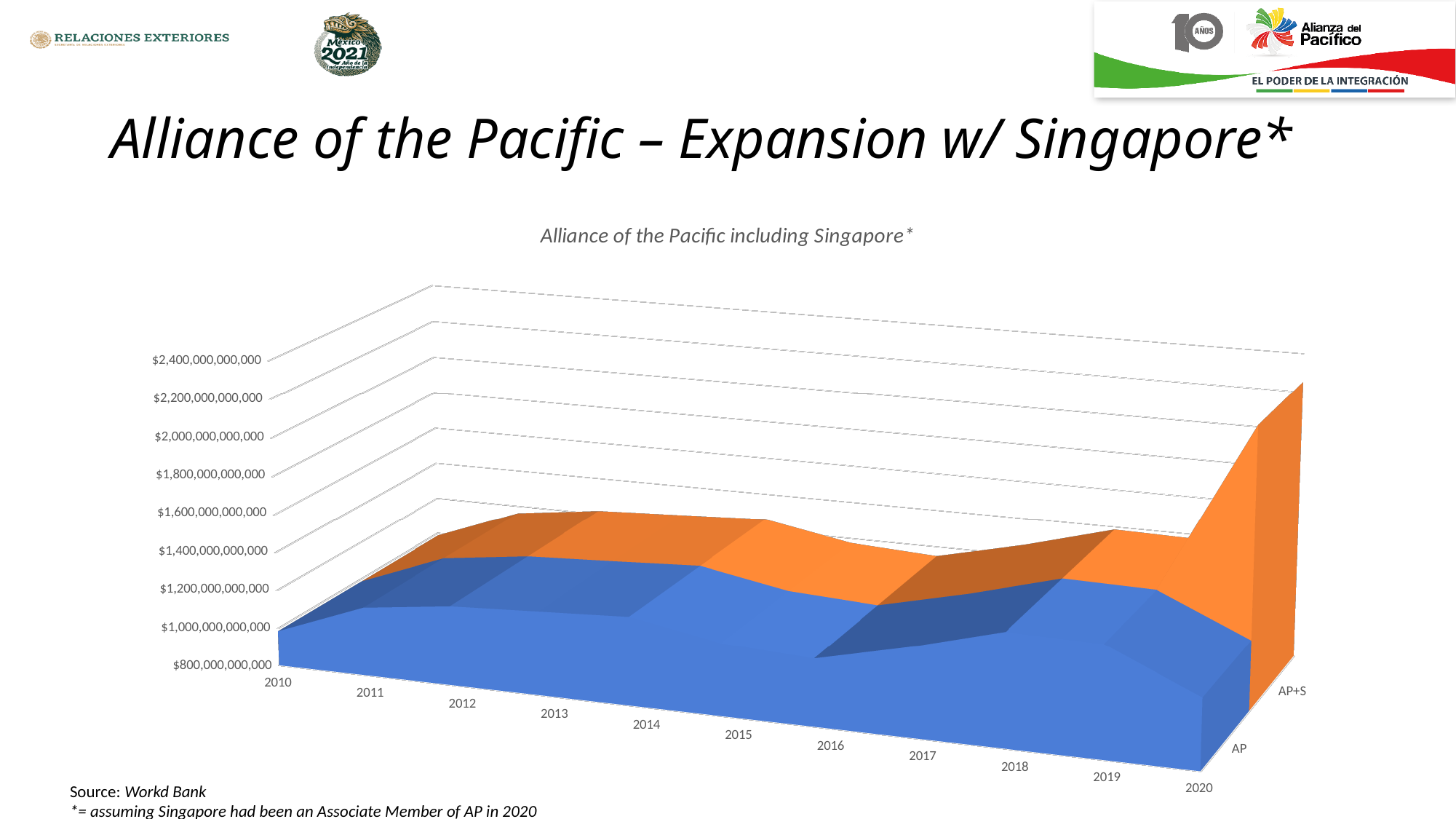
In which year does the AP+S series reach its highest value? 2020 How many years are shown along the x axis of the chart? 11 What kind of chart is shown on the slide? Area chart What is the last year shown on the x axis of the chart? 2020 Is the value of the AP+S series in 2020 greater or less than $1,800,000,000,000? greater What are the names of the two series plotted in the chart? AP and AP+S In 2020, which series has the larger value, AP or AP+S? AP+S How many series are plotted in the chart? 2 Is the value of the AP series in 2010 greater or less than $1,400,000,000,000? less What is the first year shown on the x axis of the chart? 2010 What is the title of the chart? Alliance of the Pacific including Singapore* Does the AP+S series rise or fall from 2019 to 2020? Rise